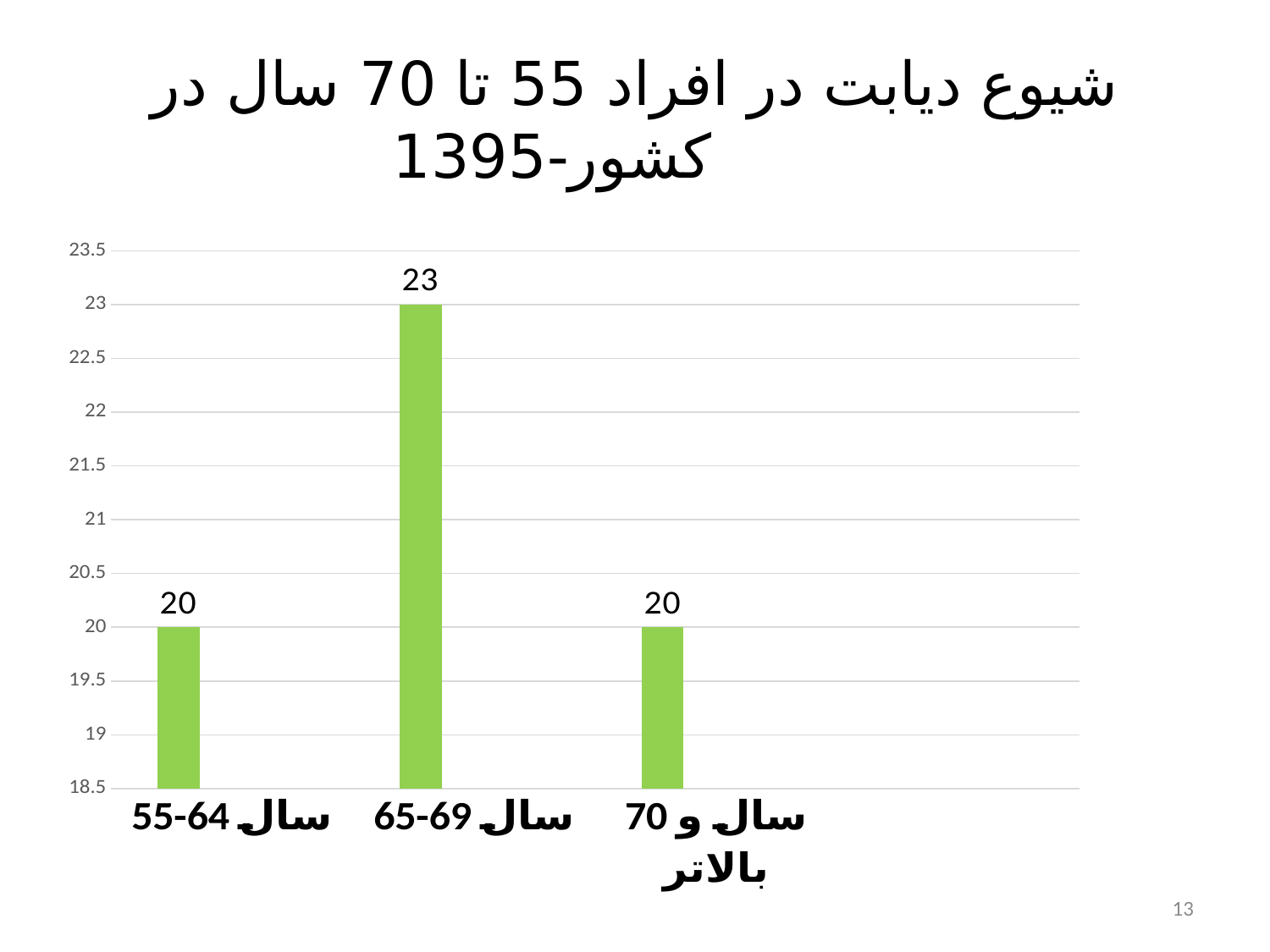
Is the value for 55-64 سال greater or less than 21? less What is the value for the 70 سال و بالاتر category? 20 Is the value for 65-69 سال greater or less than 22? greater Do the values rise or fall from the 65-69 سال category to the 70 سال و بالاتر category? fall What is the value for the 55-64 سال category? 20 How many age categories are shown on the chart? 3 What is the title of the slide? شیوع دیابت در افراد 55 تا 70 سال در کشور-1395 What kind of chart is shown on the slide? bar chart What is the value for the 65-69 سال category? 23 Which age group has the highest value? 65-69 سال Which is larger, the value for 65-69 سال or the value for 70 سال و بالاتر? 65-69 سال What is the difference between the values for 65-69 سال and 55-64 سال? 3